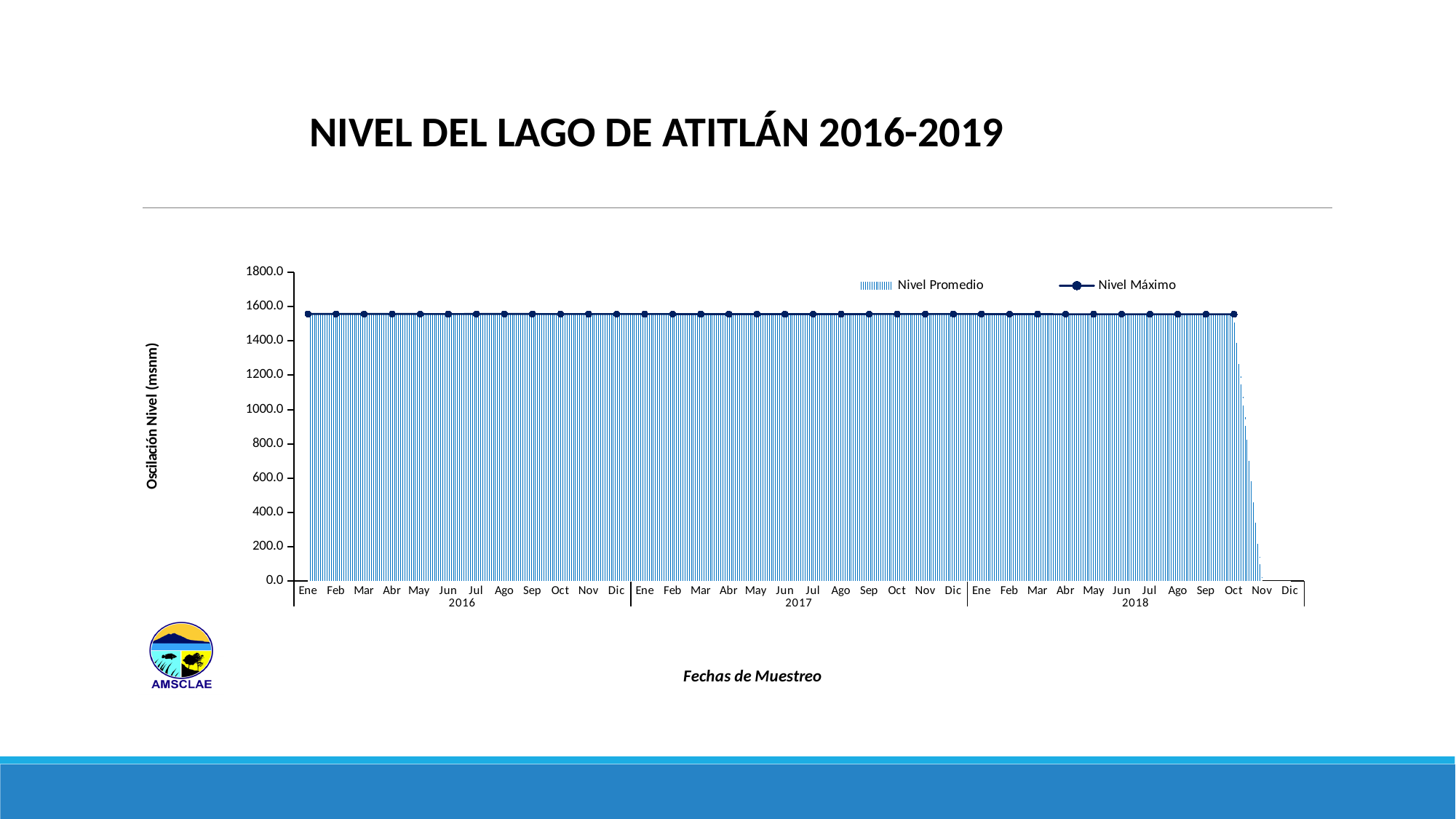
What is the highest tick value shown on the y axis? 1800.0 Is the Nivel Promedio value for Jun 2017 greater or less than 1200? greater Is the Nivel Máximo value for Oct 2018 greater or less than 1600? less Is the Nivel Máximo value for Ene 2016 greater or less than 1400? greater What kind of chart is shown on the slide? Combined area and line chart How many series does the legend list? 2 How many years are labelled along the x axis of the chart? 3 Does the Nivel Máximo line rise, fall, or stay roughly flat from Ene 2016 to Oct 2018? Stays roughly flat Which series is drawn as a line with markers, Nivel Promedio or Nivel Máximo? Nivel Máximo What is the title of the chart? NIVEL DEL LAGO DE ATITLÁN 2016-2019